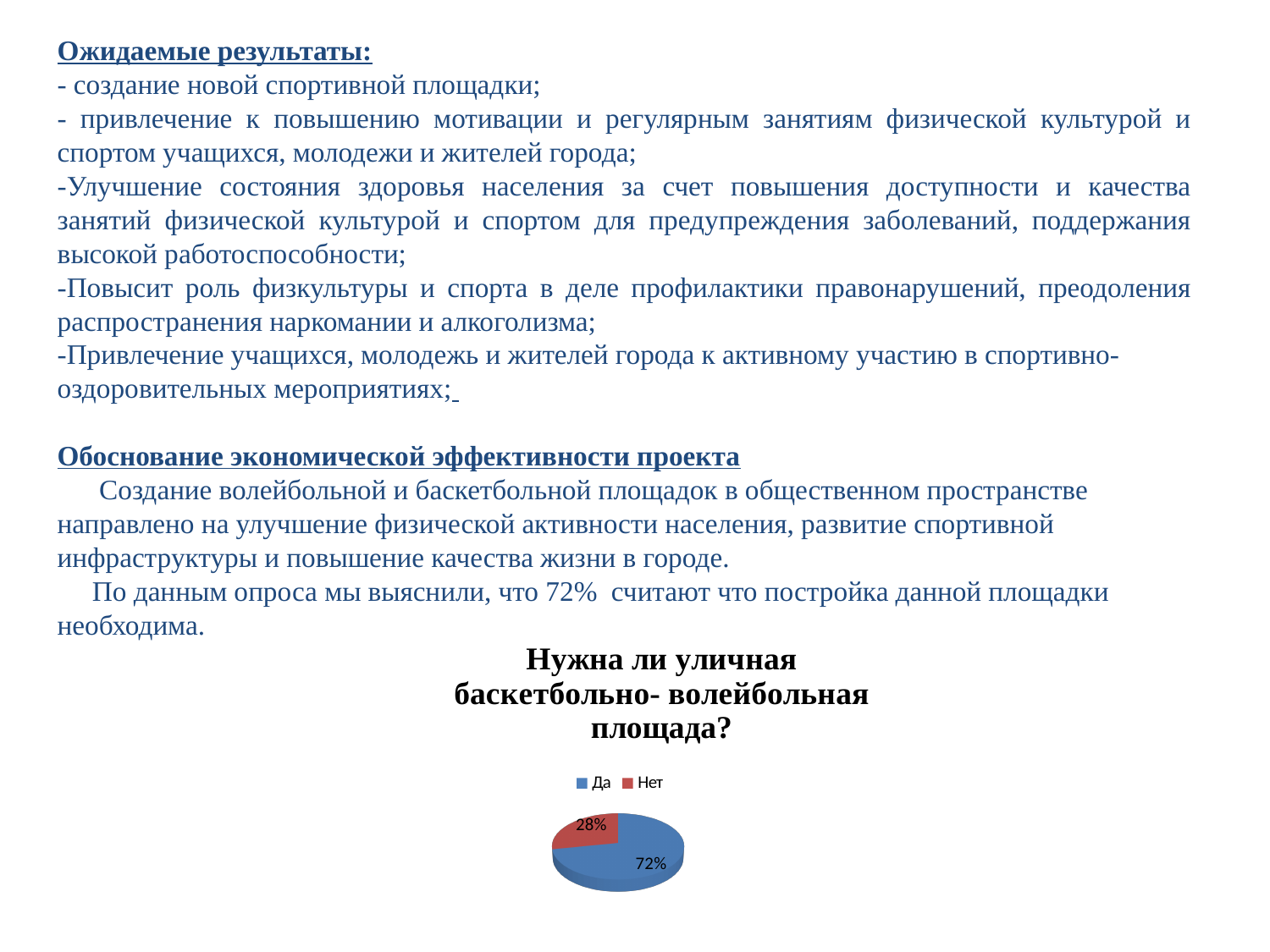
What share of the pie does "Да" take? 72% Which is larger, the "Да" slice or the "Нет" slice? Да What share of the pie does "Нет" take? 28% How many entries does the legend list? 2 Which slice of the pie is the smallest? Нет What is the difference in percentage points between the "Да" and "Нет" slices? 44 What kind of chart is shown on the slide? pie chart How many slices does the pie chart have? 2 What colour is the "Нет" slice in the pie chart? red Which slice of the pie is the largest? Да What is the title of the pie chart? Нужна ли уличная баскетбольно- волейбольная площада?